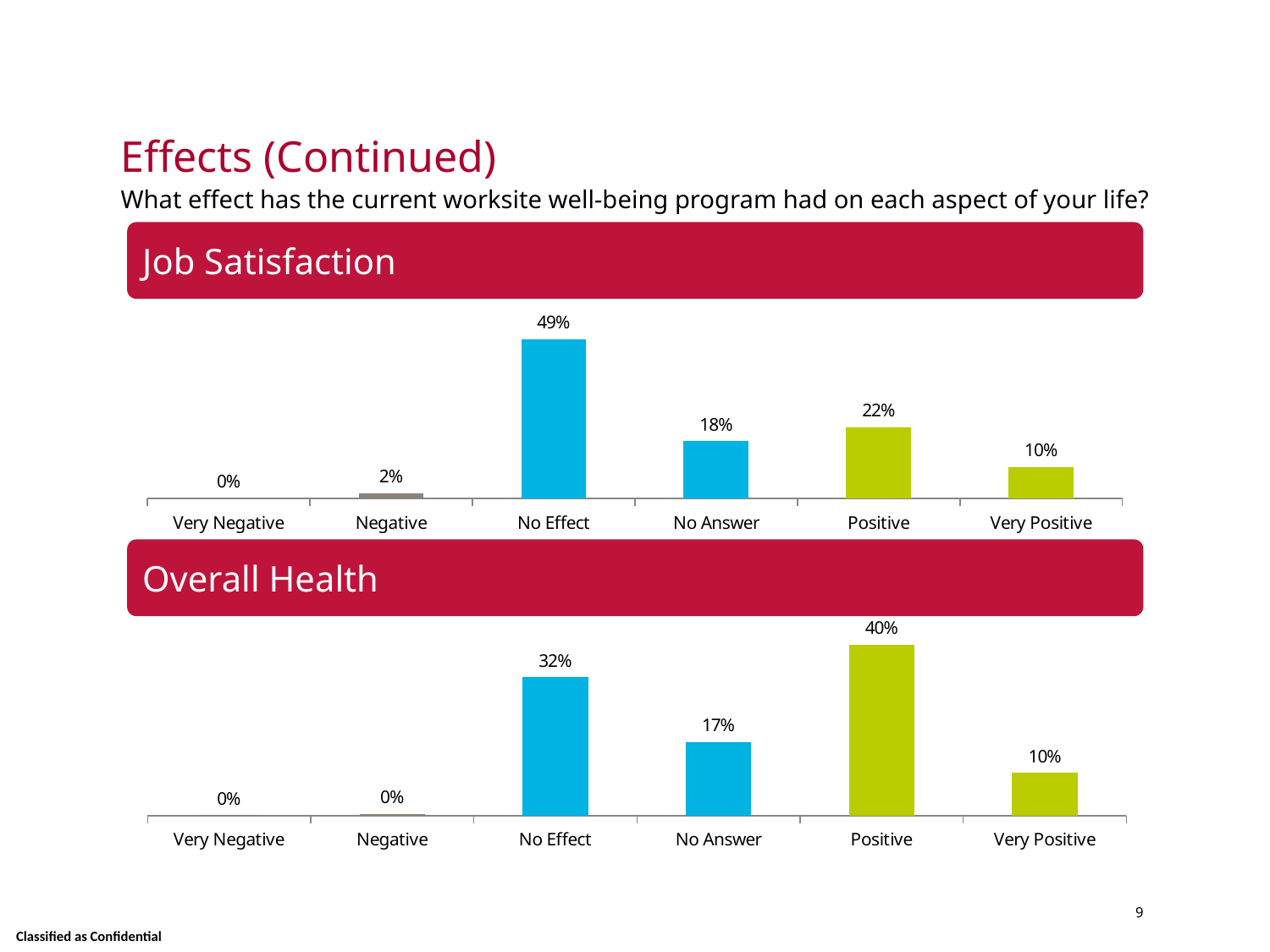
In the Overall Health chart, what is the value for Very Positive? 10% In the Job Satisfaction chart, what is the difference between the values for Positive and Very Positive? 12% In the Overall Health chart, what is the difference between the values for No Effect and No Answer? 15% In the Job Satisfaction chart, what is the value for Negative? 2% In the Job Satisfaction chart, which is larger, the value for No Answer or the value for Positive? Positive In the Overall Health chart, which is larger, the value for No Effect or the value for Positive? Positive In the Job Satisfaction chart, what is the value for No Effect? 49% How many categories are shown in the Job Satisfaction chart? 6 In the Overall Health chart, what is the value for Positive? 40% In the Job Satisfaction chart, which category has the highest value? No Effect In the Overall Health chart, which category has the highest value? Positive What kind of chart is the Overall Health chart? Bar chart